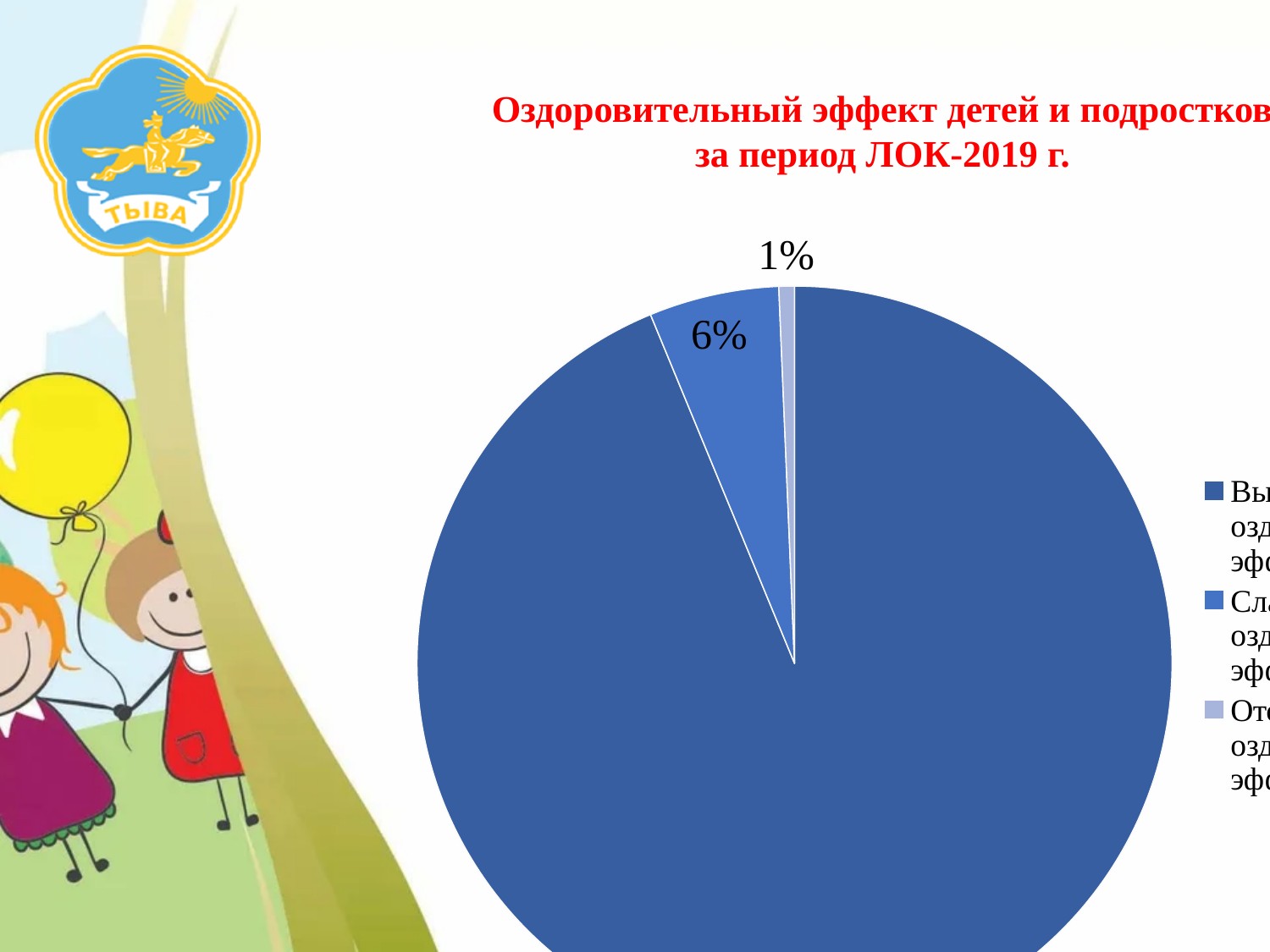
What kind of chart is shown on the slide? pie chart What colour is the largest slice of the pie? dark blue Which slice of the pie is the smallest? the light blue slice (1%) What is the difference between the 6% slice and the 1% slice? 5% What percentage is shown for the medium blue slice of the pie? 6% Which is larger, the medium blue slice or the light blue slice? the medium blue slice What is the title of the chart? Оздоровительный эффект детей и подростков за период ЛОК-2019 г. Is the dark blue slice greater or less than 50% of the pie? greater What percentage is shown for the light blue (smallest) slice of the pie? 1% How many slices does the pie chart have? 3 Which slice of the pie is the largest? the dark blue slice How many entries does the legend list? 3